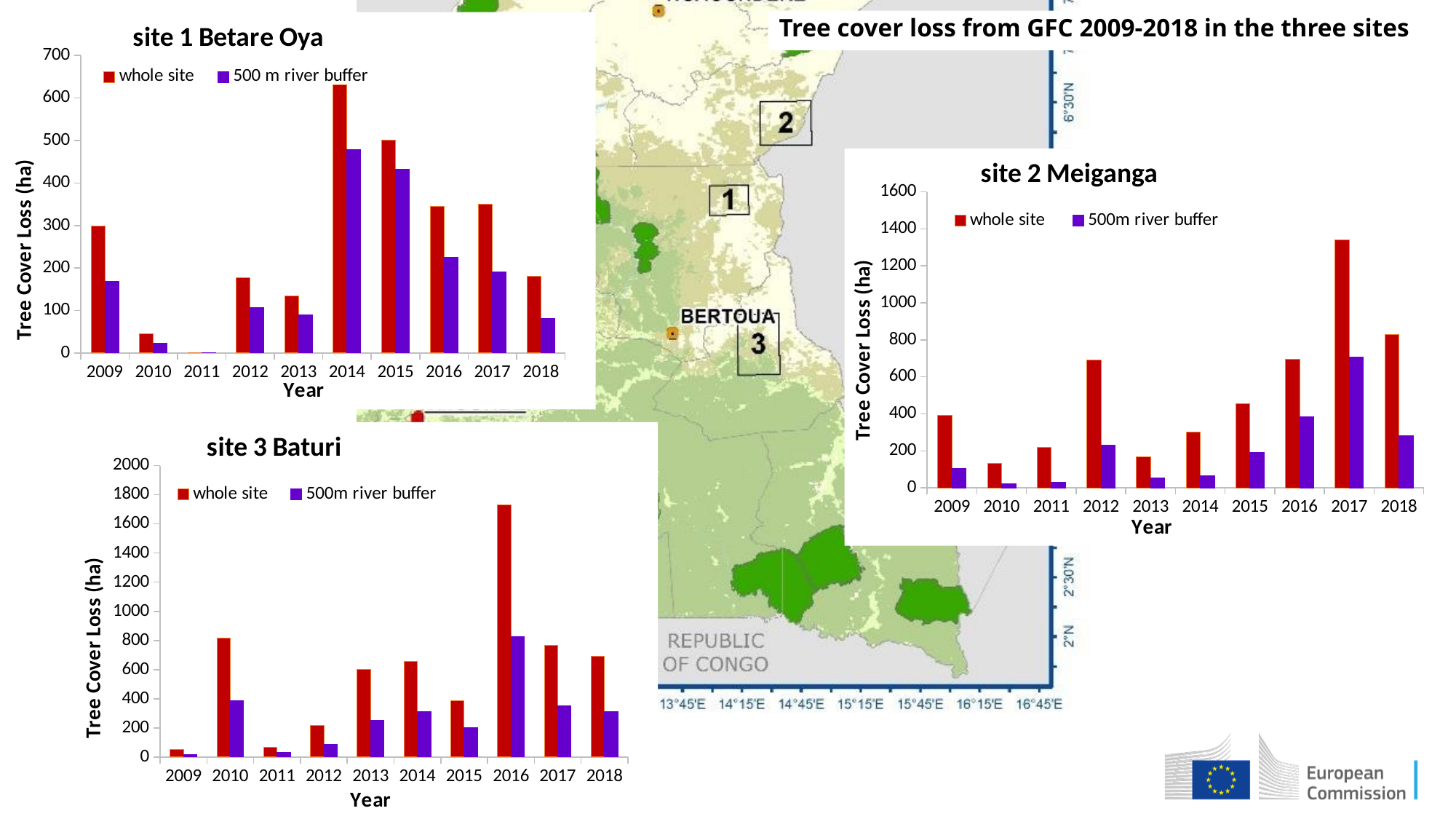
In the site 2 Meiganga chart, which year has the highest tree cover loss for the whole site? 2017 In the site 3 Baturi chart, which year has the highest tree cover loss for the 500m river buffer? 2016 In the site 1 Betare Oya chart, which year has the highest tree cover loss for the whole site? 2014 In the site 3 Baturi chart, which is larger for the whole site: 2010 or 2014? 2010 How many series does the legend of the site 2 Meiganga chart list? 2 In the site 1 Betare Oya chart, which is larger for the whole site: 2015 or 2016? 2015 In the site 1 Betare Oya chart, is the whole site value for 2014 greater or less than 600? greater In the site 2 Meiganga chart, which year has the lowest tree cover loss for the whole site? 2010 In the site 2 Meiganga chart, is the whole site value for 2017 greater or less than 1200? greater In the site 3 Baturi chart, is the whole site value for 2016 greater or less than 1600? greater In the site 1 Betare Oya chart, which year has the lowest tree cover loss for the whole site? 2011